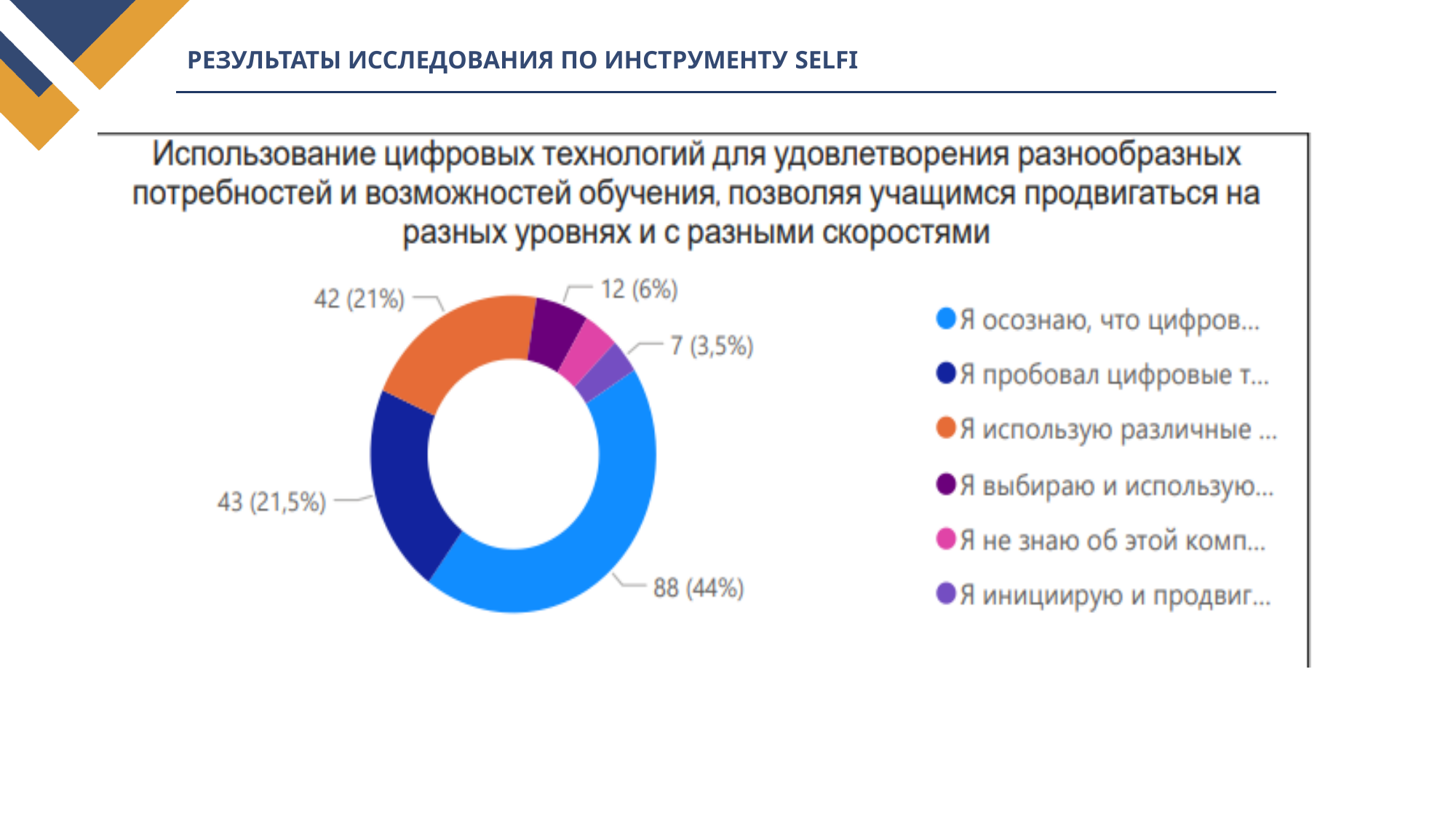
What value is shown for the slice "Я осознаю, что цифров..."? 88 (44%) What value is shown for the slice "Я пробовал цифровые т..."? 43 (21,5%) What colour is the largest slice of the chart? light blue What is the difference between the counts for "Я осознаю, что цифров..." (88) and "Я пробовал цифровые т..." (43)? 45 What is the smallest value printed as a data label on the chart? 7 (3,5%) Which legend entry corresponds to the largest slice of the chart? Я осознаю, что цифров... How many entries does the legend of the chart list? 6 What value is shown for the slice "Я использую различные ..."? 42 (21%) What kind of chart is shown on the slide? pie chart (donut) What share of the chart does the slice "Я осознаю, что цифров..." take? 44% Which is larger: the count for "Я осознаю, что цифров..." or the count for "Я использую различные ..."? Я осознаю, что цифров... What value is shown for the slice "Я выбираю и использую..."? 12 (6%)